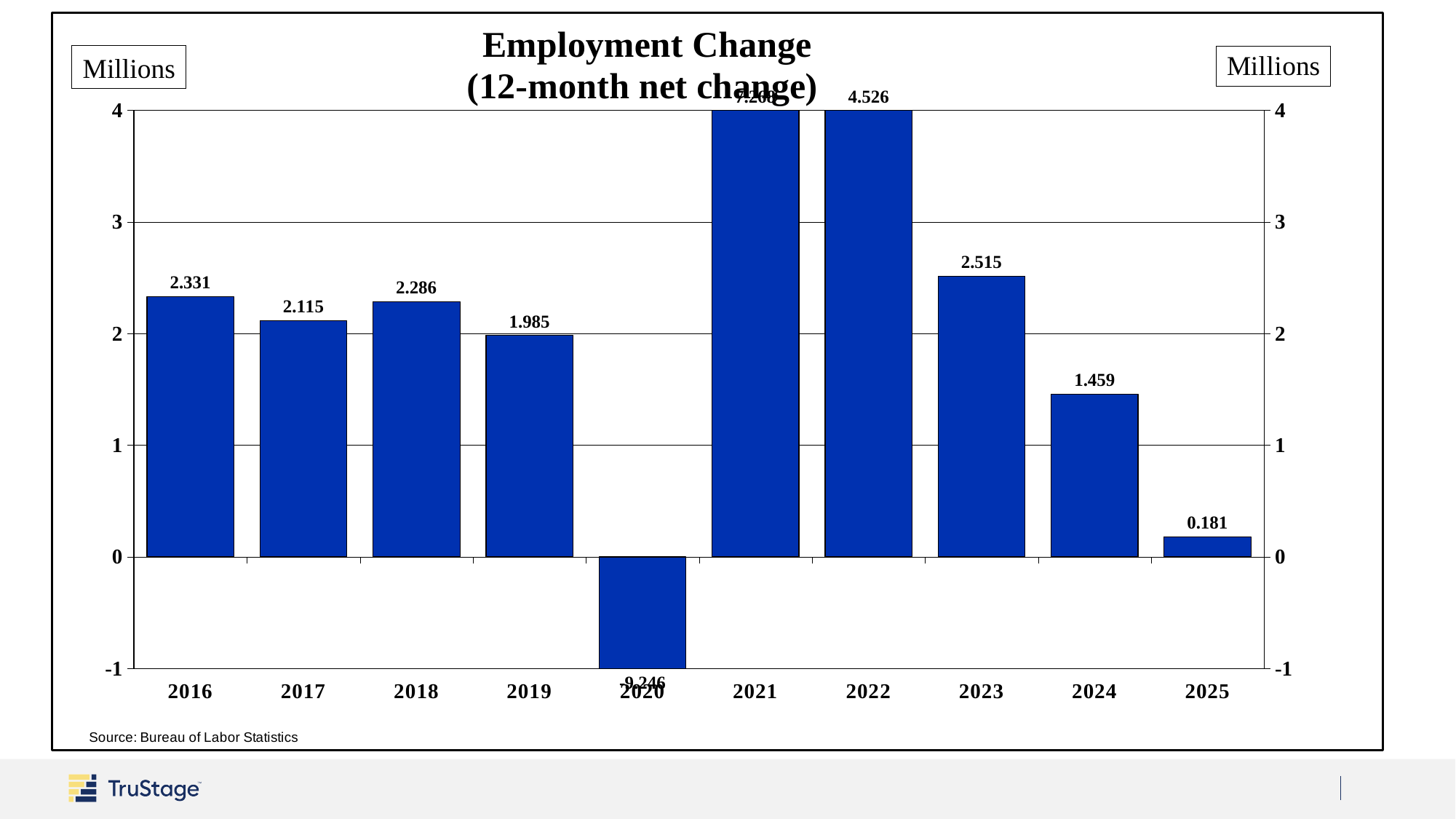
What is the employment change value for 2016? 2.331 Do the values rise or fall from 2022 to 2025? Fall What is the source cited for the chart? Bureau of Labor Statistics How many years are shown on the x axis? 10 Which year has the lowest employment change? 2020 Which year has the larger value, 2017 or 2018? 2018 What is the employment change value for 2025? 0.181 What is the difference between the values for 2016 and 2017? 0.216 What is the employment change value for 2022? 4.526 What is the difference between the values for 2023 and 2024? 1.056 What kind of chart is shown on the slide? Bar chart What is the employment change value for 2023? 2.515